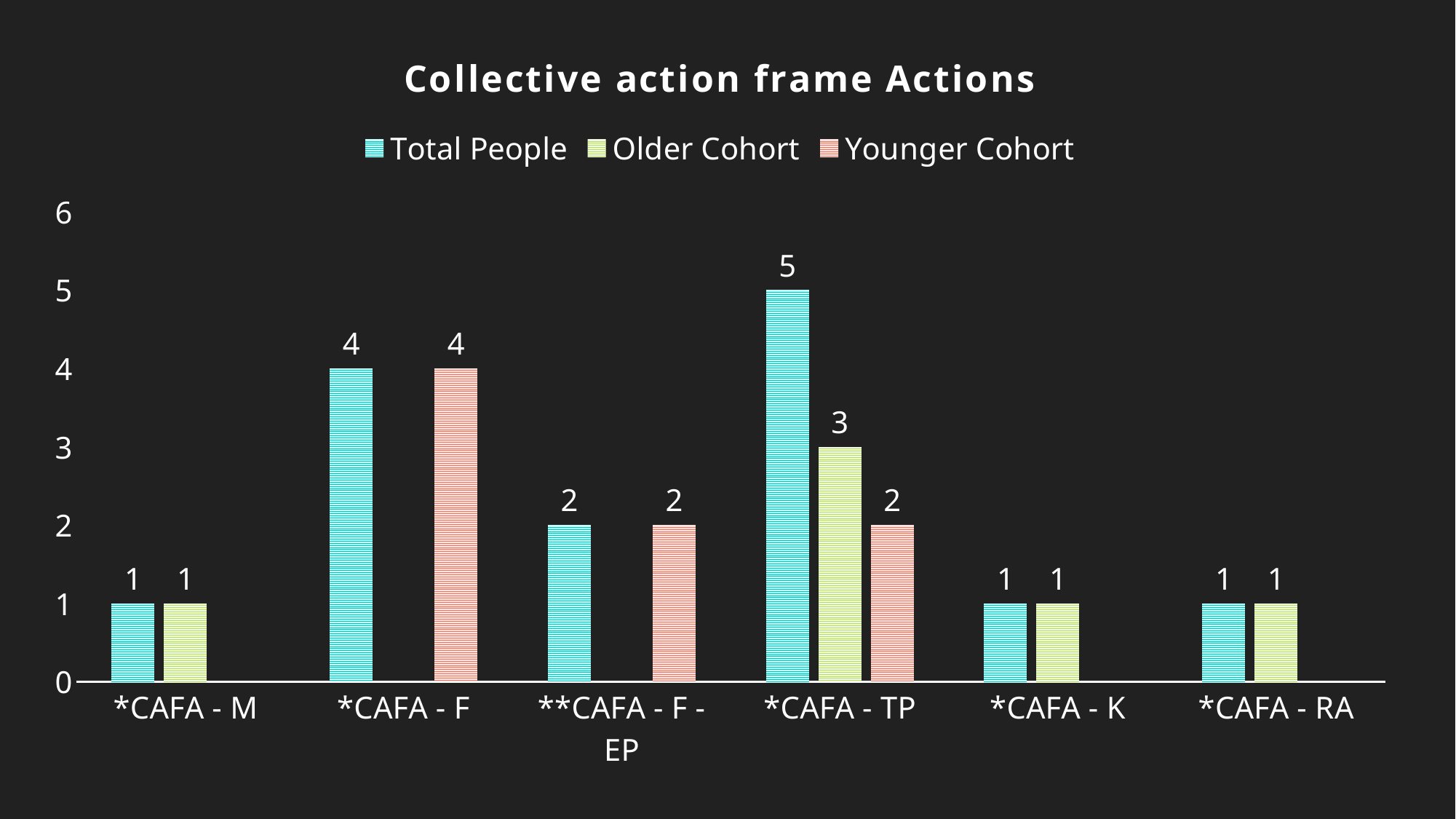
What is the title of the chart? Collective action frame Actions What is the difference between the Total People values for *CAFA - TP and *CAFA - F? 1 What is the Total People value for **CAFA - F - EP? 2 What is the difference between the Older Cohort and Younger Cohort values for *CAFA - TP? 1 Which category has the highest Total People value? *CAFA - TP What is the Older Cohort value for *CAFA - TP? 3 Which is larger for *CAFA - TP: the Older Cohort value or the Younger Cohort value? Older Cohort What is the Younger Cohort value for *CAFA - F? 4 What kind of chart is shown on the slide? Bar chart How many categories are shown on the x axis? 6 How many series does the legend list? 3 What is the Total People value for *CAFA - TP? 5